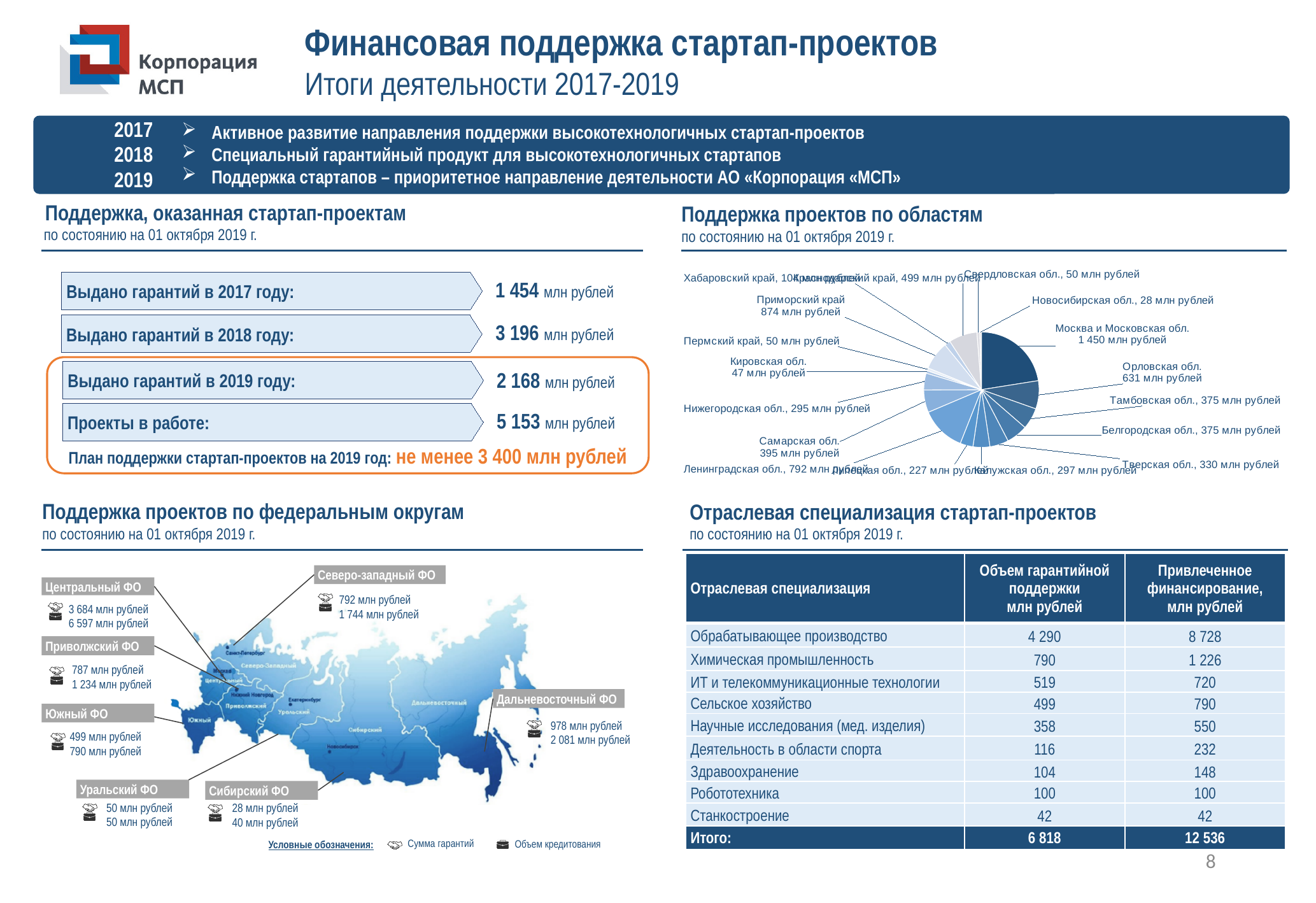
In the pie chart "Поддержка проектов по областям", which region has the smallest value? Новосибирская обл. In the pie chart "Поддержка проектов по областям", what is the difference between Москва и Московская обл. and Орловская обл.? 819 млн рублей In the pie chart "Поддержка проектов по областям", which region has the largest value? Москва и Московская обл. In the pie chart "Поддержка проектов по областям", what is the difference between Тверская обл. and Липецкая обл.? 103 млн рублей What kind of chart is used in "Поддержка проектов по областям"? pie chart In the pie chart "Поддержка проектов по областям", what is the value for Калужская обл.? 297 млн рублей In the pie chart "Поддержка проектов по областям", what is the value for Приморский край? 874 млн рублей In the pie chart "Поддержка проектов по областям", what is the value for Самарская обл.? 395 млн рублей In the pie chart "Поддержка проектов по областям", what is the value for Орловская обл.? 631 млн рублей In the pie chart "Поддержка проектов по областям", which is larger: Приморский край or Ленинградская обл.? Приморский край What is the subtitle (date) shown under the pie chart title "Поддержка проектов по областям"? по состоянию на 01 октября 2019 г. In the pie chart "Поддержка проектов по областям", what is the value for Москва и Московская обл.? 1 450 млн рублей